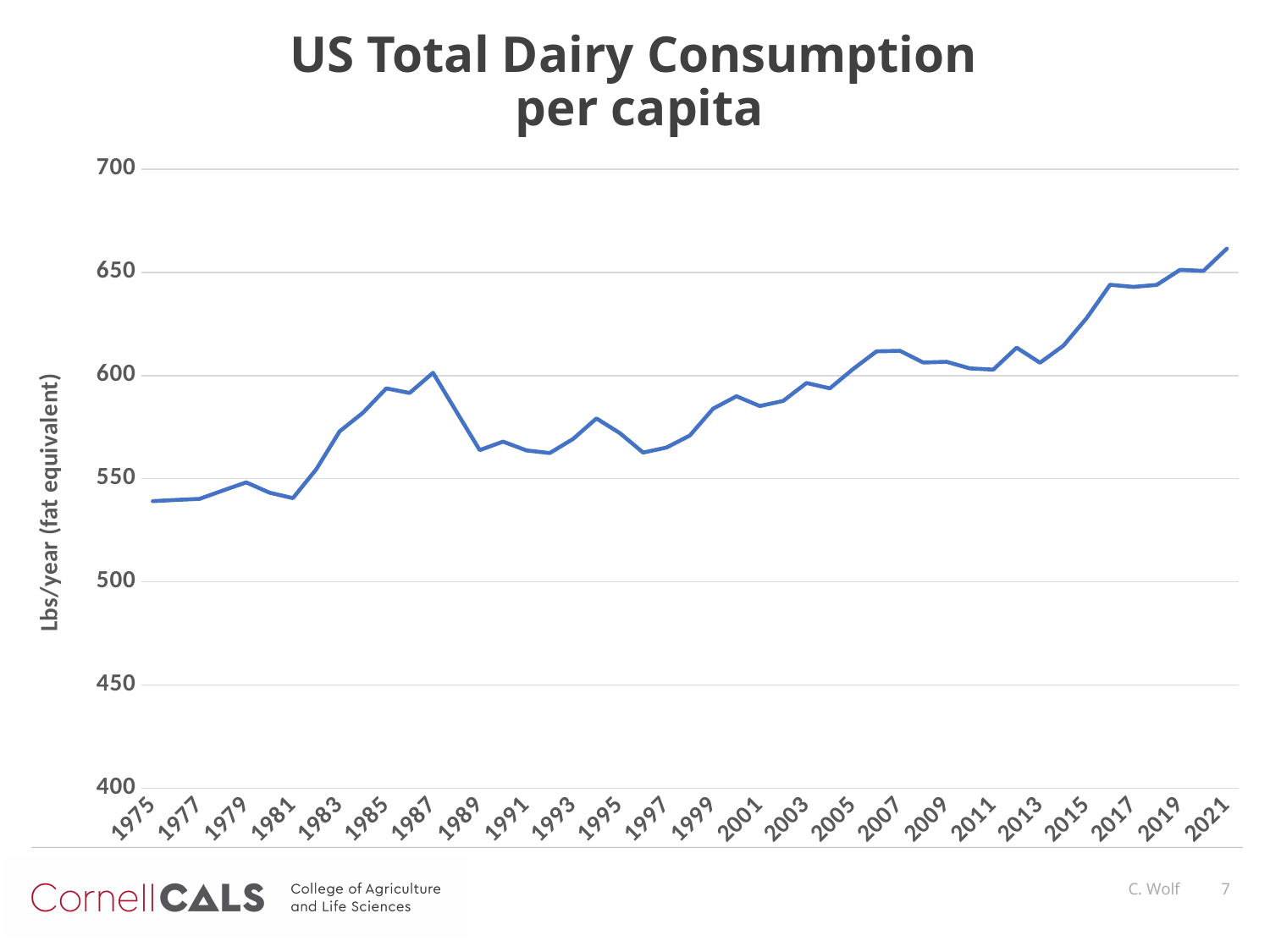
Is the value for 2007 greater or less than 600? greater What is the label on the vertical axis? Lbs/year (fat equivalent) Overall, do the values rise or fall from 1975 to 2021? rise Which is larger, the value for 1987 or the value for 1989? 1987 Is the value for 1975 greater or less than 550? less Which year has the highest value on the chart? 2021 Is the value for 1989 greater or less than 600? less Which is larger, the value for 2021 or the value for 1975? 2021 What kind of chart is shown on the slide? line chart What is the title of the chart? US Total Dairy Consumption per capita